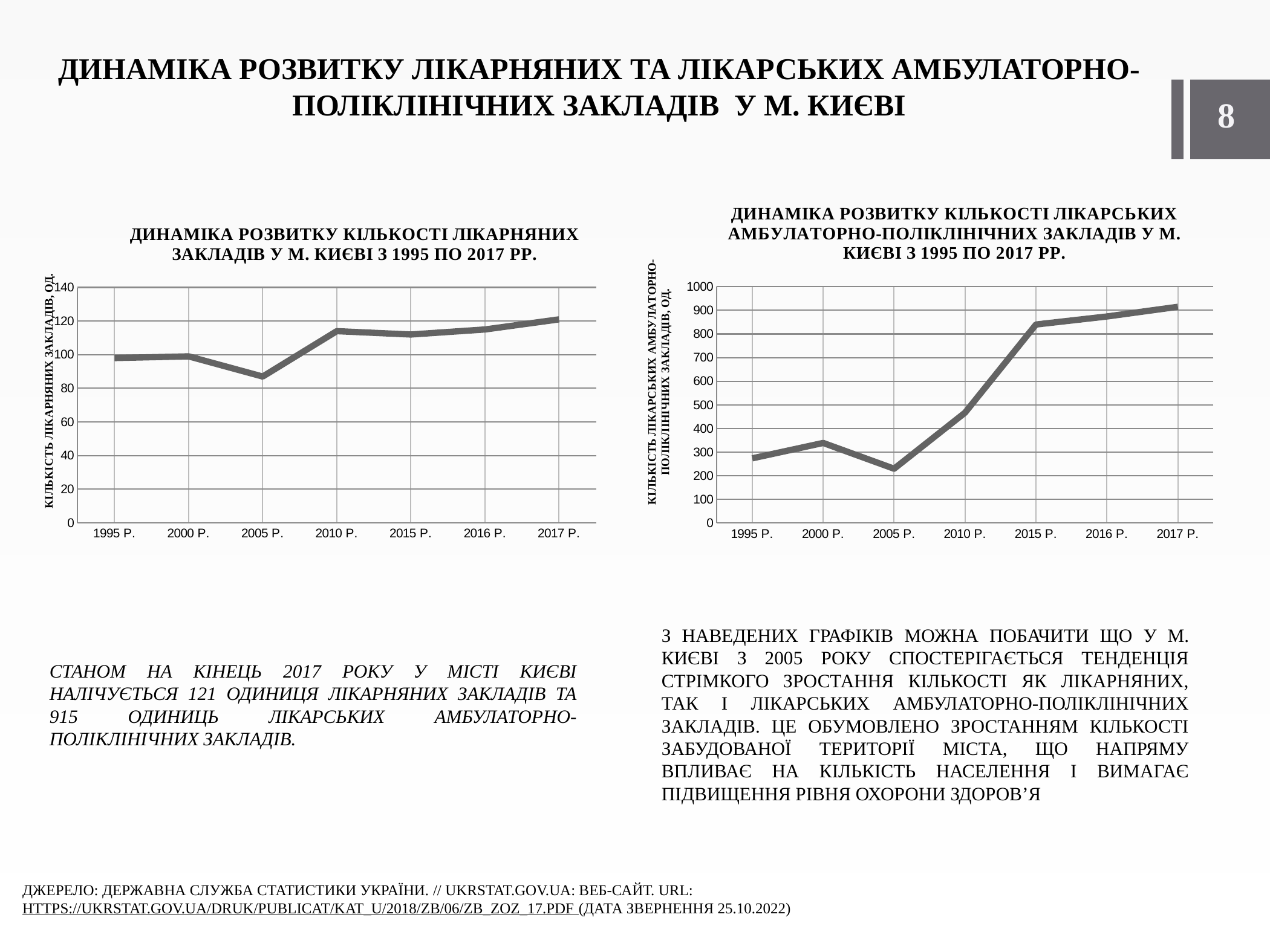
In the right chart (амбулаторно-поліклінічних закладів), which year has the lowest value? 2005 р. In the left chart (лікарняних закладів), is the value for 2005 р. greater or less than 100? less In the left chart (лікарняних закладів), which year has the lowest value? 2005 р. What kind of chart is the left chart, 'Динаміка розвитку кількості лікарняних закладів у м. Києві з 1995 по 2017 рр.'? Line chart In the right chart (амбулаторно-поліклінічних закладів), do the values rise or fall from 2005 р. to 2017 р.? Rise How many years are plotted on the x axis of the right chart, 'Динаміка розвитку кількості лікарських амбулаторно-поліклінічних закладів у м. Києві з 1995 по 2017 рр.'? 7 In the right chart (амбулаторно-поліклінічних закладів), which is larger: the value for 2000 р. or the value for 2005 р.? 2000 р. In the right chart (амбулаторно-поліклінічних закладів), which year has the highest value? 2017 р. In the right chart (амбулаторно-поліклінічних закладів), is the value for 2010 р. greater or less than 400? greater In the left chart (лікарняних закладів), which year has the highest value? 2017 р. What is the y-axis label of the left chart (лікарняних закладів)? КІЛЬКІСТЬ ЛІКАРНЯНИХ ЗАКЛАДІВ, ОД.